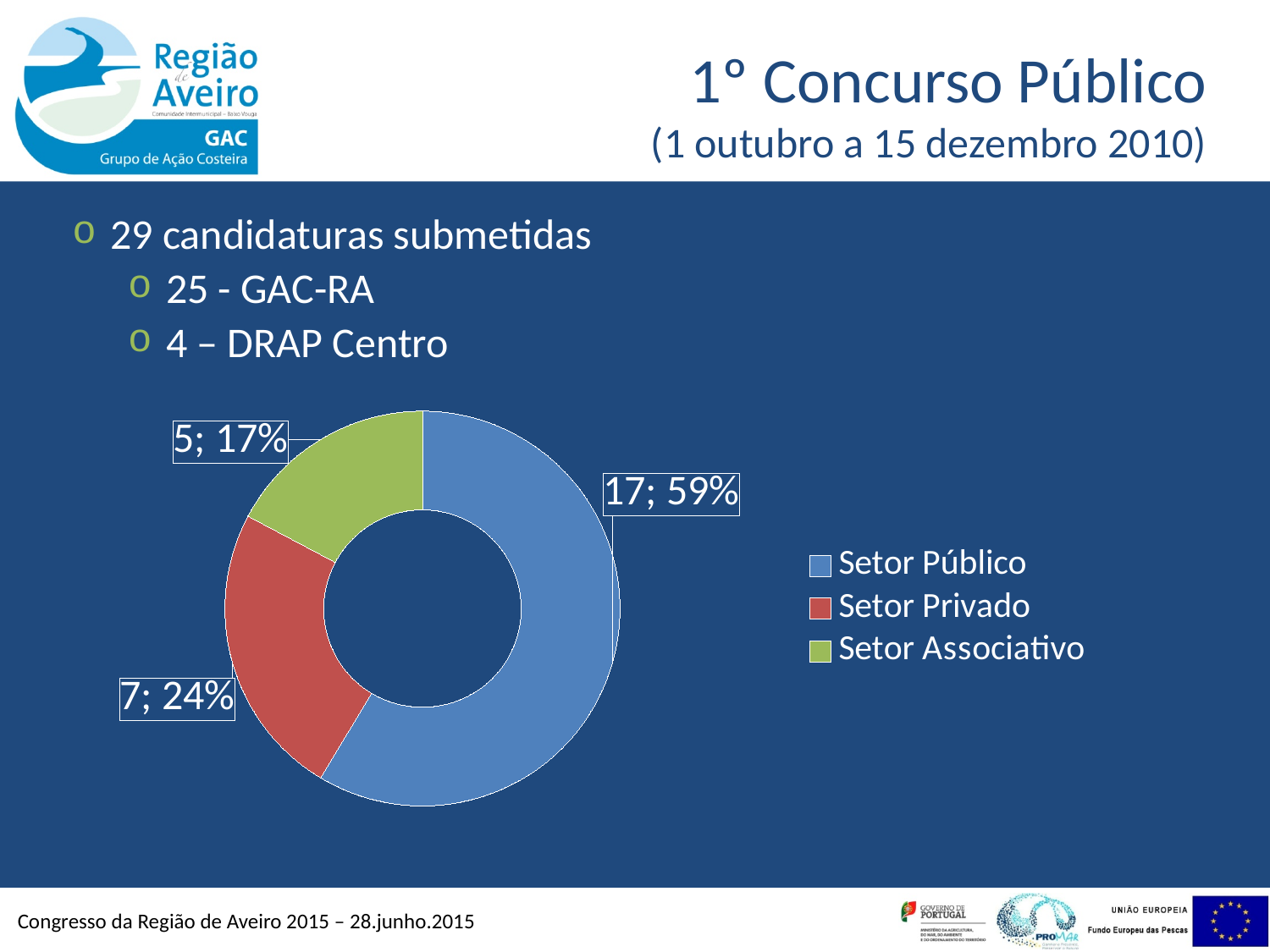
Which category has the highest value? Setor Público What is the difference between the values for Setor Público and Setor Privado? 10 What share of the chart does Setor Público represent? 59% What is the value for Setor Associativo? 5 What is the value for Setor Público? 17 What is the value for Setor Privado? 7 How many entries does the legend list? 3 Which colour represents Setor Privado in the chart? Red What kind of chart is shown on the slide? Doughnut (pie) chart What share of the chart does Setor Associativo represent? 17% Which category has the lowest value? Setor Associativo How many categories does the chart show? 3